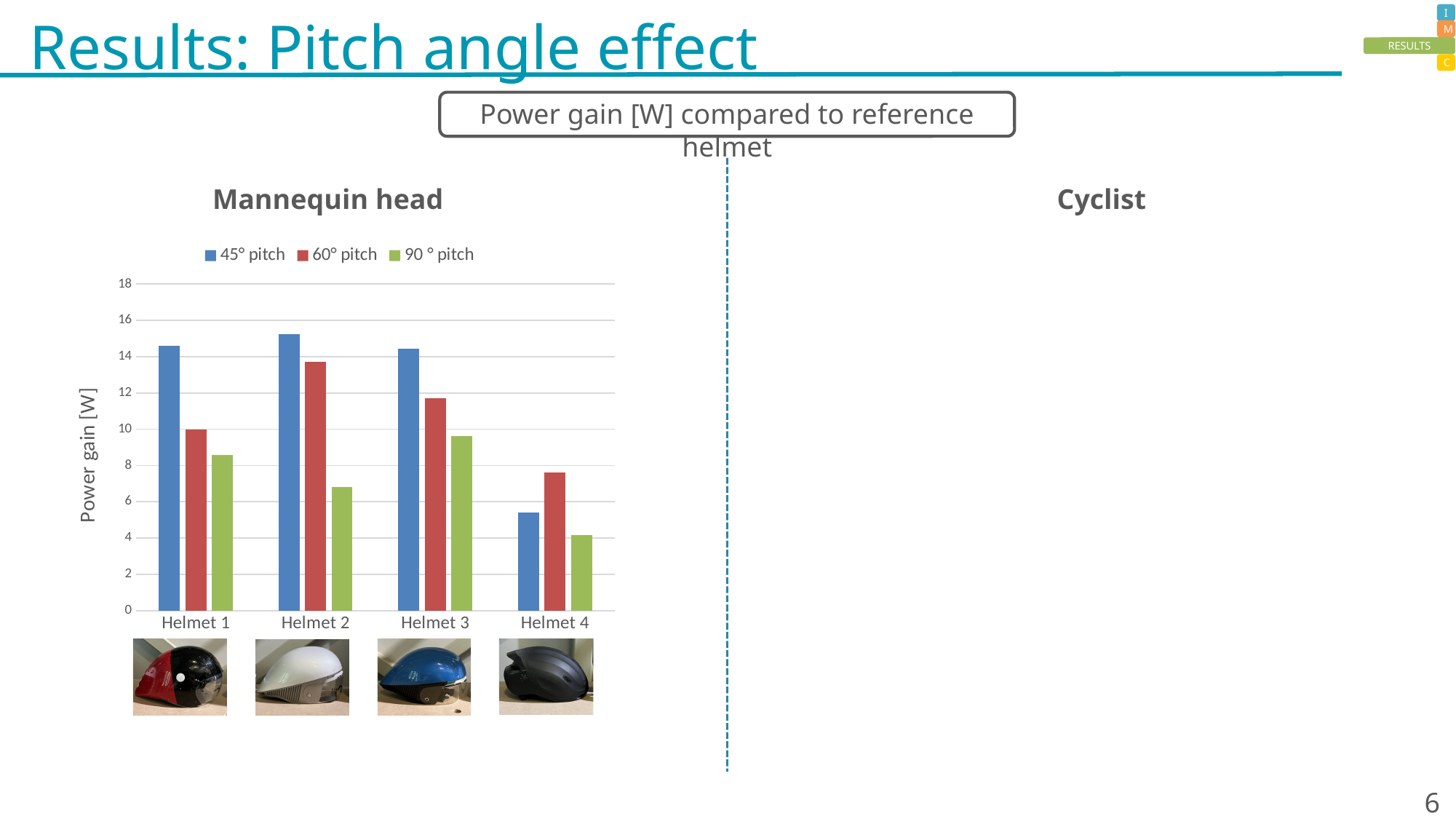
What kind of chart is shown under the Mannequin head heading? bar chart How many series does the legend of the Mannequin head chart list? 3 In the Mannequin head chart, is the 45° pitch value for Helmet 2 greater or less than 14? greater In the Mannequin head chart, which helmet has the lowest value for 90 ° pitch? Helmet 4 In the Mannequin head chart, for Helmet 4, which is larger: the 45° pitch value or the 60° pitch value? 60° pitch In the Mannequin head chart, which helmet has the highest value for 60° pitch? Helmet 2 In the Mannequin head chart, which helmet has the highest value for 90 ° pitch? Helmet 3 How many helmets are shown on the x axis of the Mannequin head chart? 4 In the Mannequin head chart, is the 90 ° pitch value for Helmet 4 greater or less than 6? less In the Mannequin head chart, is the 60° pitch value for Helmet 3 greater or less than 10? greater What is the y-axis title of the Mannequin head chart? Power gain [W] In the Mannequin head chart, which helmet has the lowest value for 45° pitch? Helmet 4